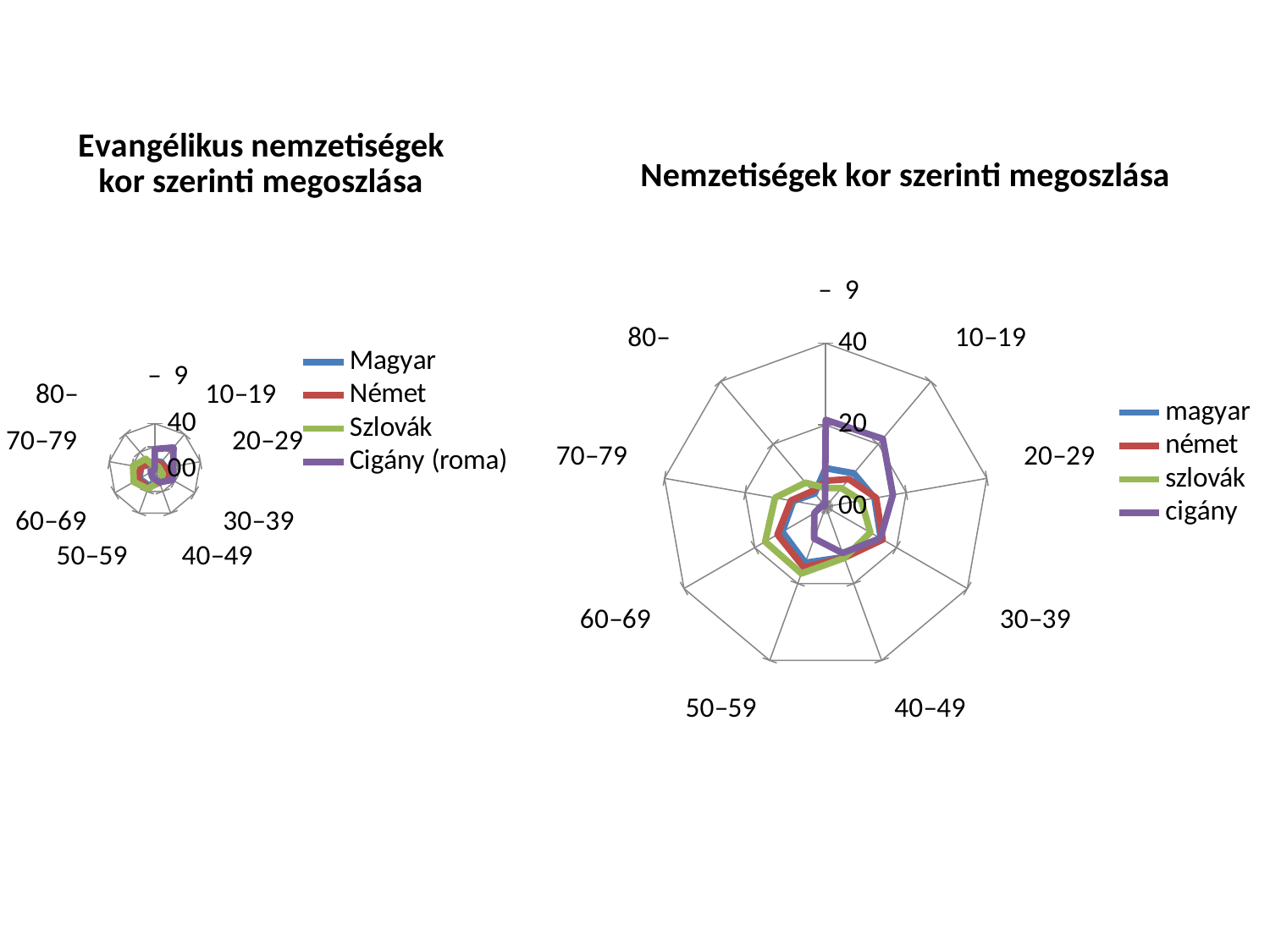
On the chart titled "Nemzetiségek kor szerinti megoszlása", which series has the lowest value for the 60–69 age group? cigány On the chart titled "Nemzetiségek kor szerinti megoszlása", is the value for szlovák in the 10–19 age group greater or less than 20? less How many series does the legend of the chart titled "Nemzetiségek kor szerinti megoszlása" list? 4 On the chart titled "Nemzetiségek kor szerinti megoszlása", which is larger for the 60–69 age group: szlovák or cigány? szlovák On the chart titled "Nemzetiségek kor szerinti megoszlása", which series is shown in purple? cigány How many age categories are plotted on the chart titled "Evangélikus nemzetiségek kor szerinti megoszlása"? 9 On the chart titled "Nemzetiségek kor szerinti megoszlása", which is larger for the 10–19 age group: cigány or magyar? cigány On the chart titled "Nemzetiségek kor szerinti megoszlása", which series has the highest value for the 60–69 age group? szlovák On the chart titled "Nemzetiségek kor szerinti megoszlása", is the value for cigány in the 80– age group greater or less than 20? less Which series are listed in the legend of the chart titled "Evangélikus nemzetiségek kor szerinti megoszlása"? Magyar, Német, Szlovák, Cigány (roma) What kind of chart is the chart titled "Nemzetiségek kor szerinti megoszlása"? radar chart On the chart titled "Nemzetiségek kor szerinti megoszlása", which series has the highest value for the –9 age group? cigány